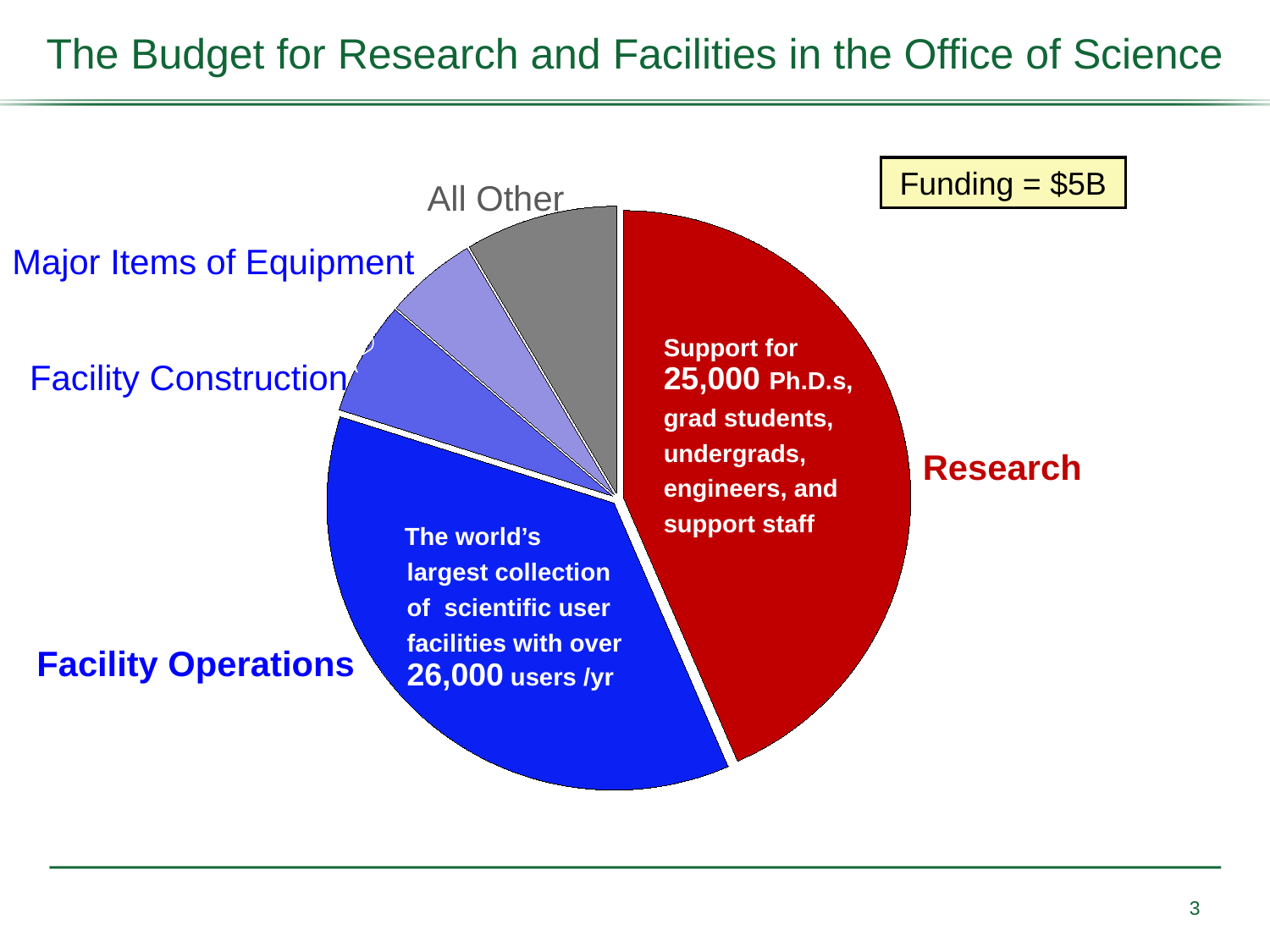
How many slices does the pie chart have? 5 What is the title of the slide containing the pie chart? The Budget for Research and Facilities in the Office of Science What kind of chart is shown on the slide? pie chart Which category has the largest slice of the pie chart? Research Which slice is larger, All Other or Major Items of Equipment? All Other Which slice is larger, Facility Operations or All Other? Facility Operations What total funding amount is shown in the box next to the pie chart? Funding = $5B Which slice is larger, Facility Operations or Facility Construction? Facility Operations